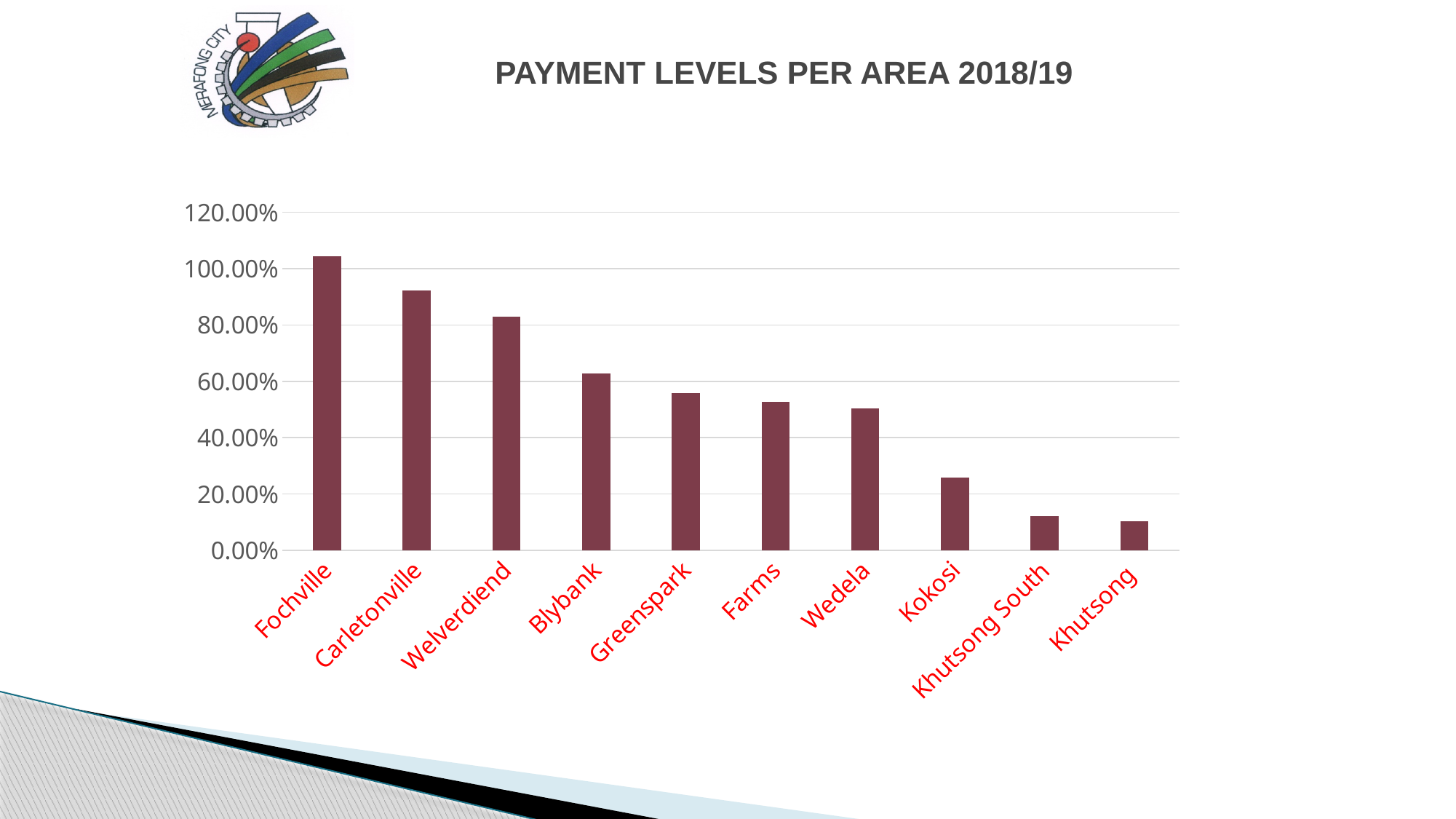
Do the payment levels rise or fall moving from left to right along the x axis? fall Which has a higher payment level, Carletonville or Blybank? Carletonville Is the value for Greenspark greater or less than 60.00%? less What is the title of the chart? PAYMENT LEVELS PER AREA 2018/19 Is the value for Khutsong South greater or less than 20.00%? less Which area has the highest payment level? Fochville What kind of chart is shown on the slide? bar chart Is the value for Carletonville greater or less than 100.00%? less How many areas are shown on the x axis of the chart? 10